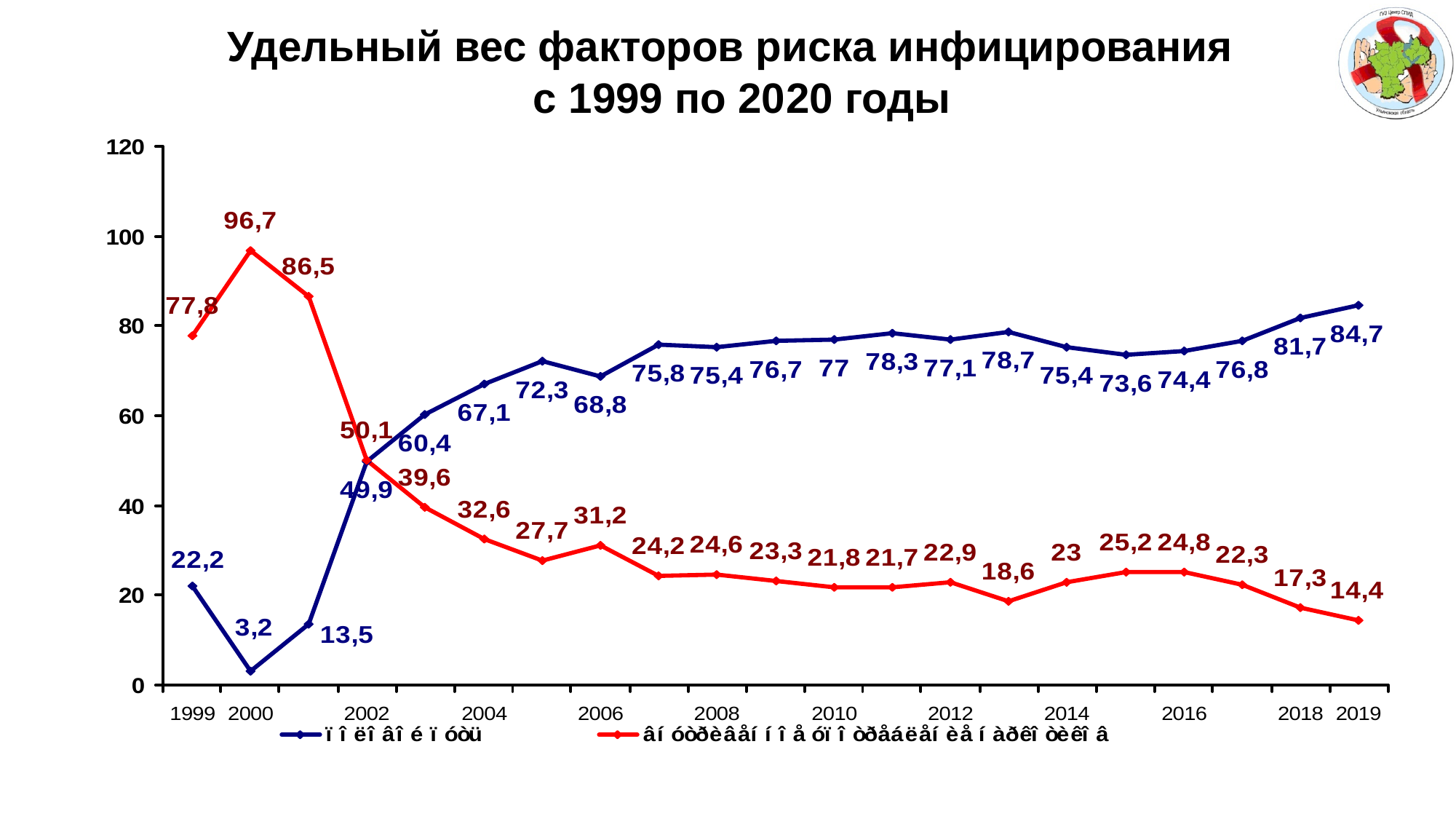
What is the value of the red line in 2000? 96,7 In which year does the red line reach its highest value? 2000 In which year does the blue line reach its lowest value? 2000 How many series does the legend list? 2 What is the value of the blue line in 2002? 49,9 Is the value of the red line in 2013 greater or less than 20? less What is the difference between the red line's value in 1999 and its value in 2019? 63,4 What is the value of the blue line in 2019? 84,7 Does the red line generally rise or fall from 2000 to 2019? fall How many years are plotted on the x axis? 21 Which line has the larger value in 2001, the blue line or the red line? red line What type of chart is shown on the slide? line chart